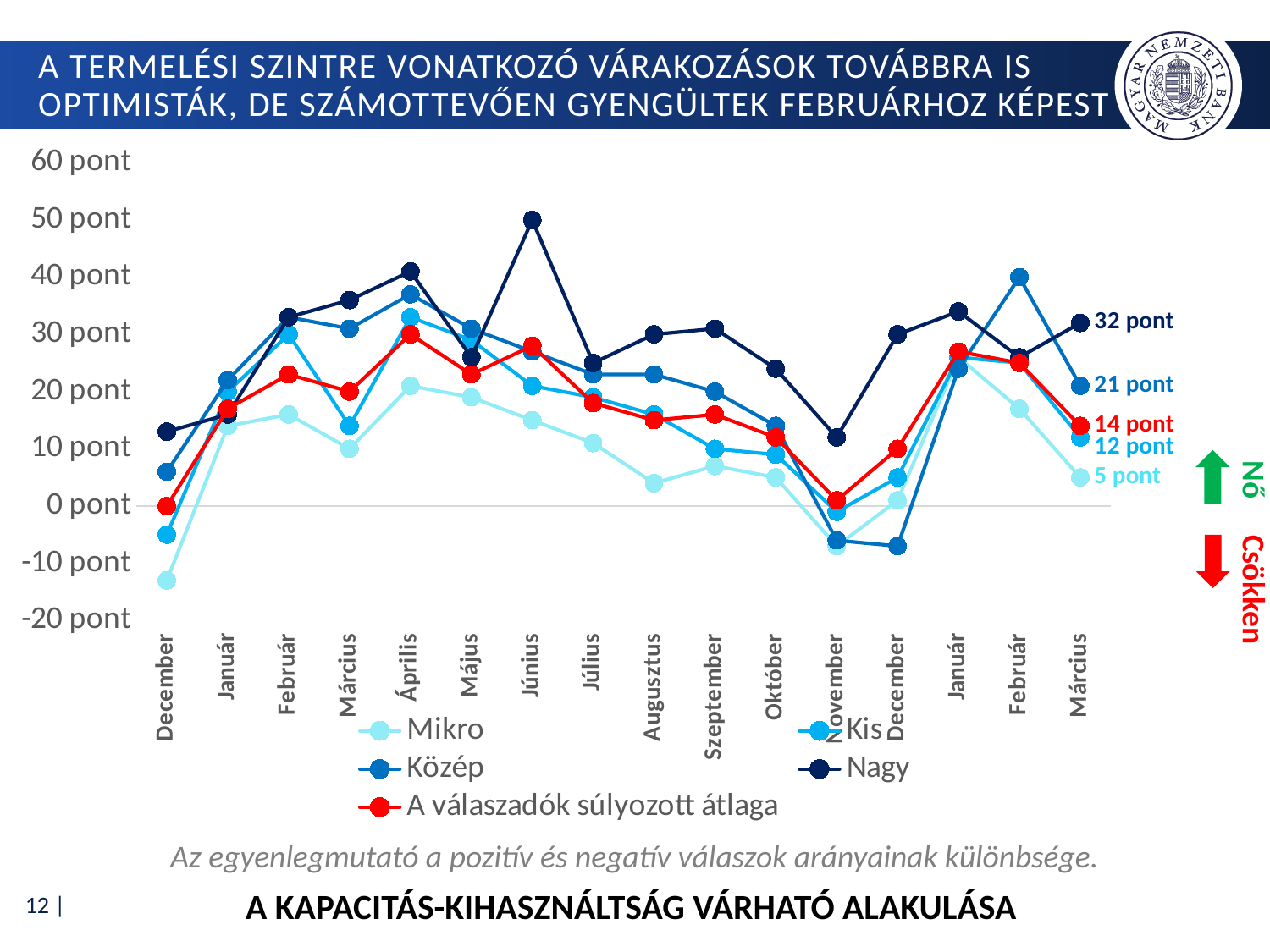
What type of chart is shown on the slide? line chart How many time points are shown along the x axis? 16 What is the value for the Mikro series at the final Március point? 5 pont At the final Március point, which is larger: the Közép value or the Kis value? Közép What is the difference between the Nagy and Mikro values at the final Március point? 27 pont What is the value for the Nagy series at the final Március point? 32 pont How many series does the legend list? 5 Which series has the highest value at the final Március point? Nagy Which series has the lowest value at the final Március point? Mikro What is the value for the Közép series at the final Március point? 21 pont Is the value for the Nagy series in Június greater or less than 40 pont? greater What is the value for 'A válaszadók súlyozott átlaga' at the final Március point? 14 pont